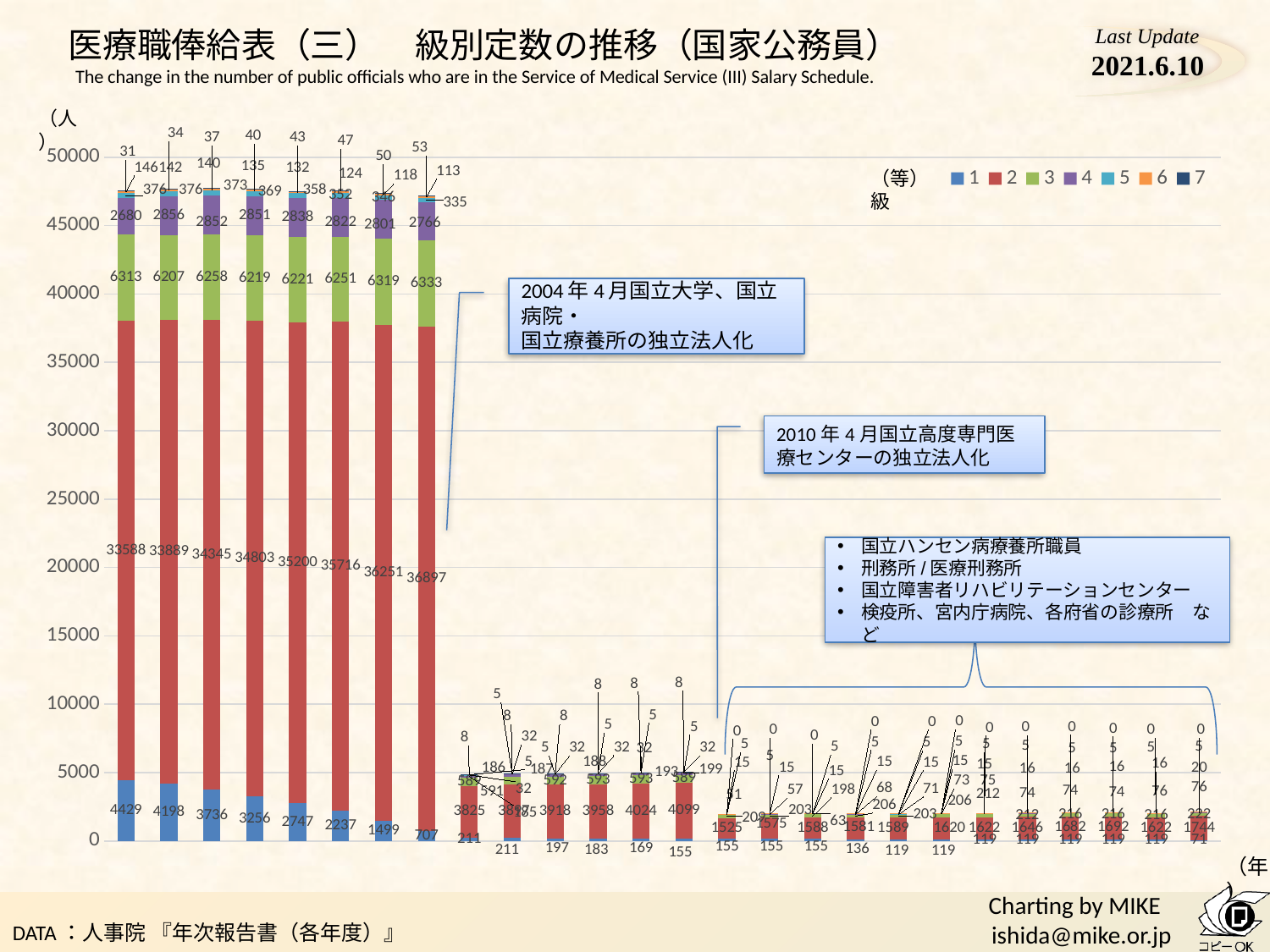
Across the first eight tall bars, does the value for grade 2 rise or fall from left to right? Rise What is the value for grade 1 (級 1) in the leftmost bar? 4429 What is the value for grade 3 (級 3) in the eighth bar from the left (the last of the tall bars)? 6333 What is the total of the leftmost stacked bar? 47563 How many series (grades) does the legend list? 7 What is the difference between the grade 1 value in the leftmost bar (4429) and the grade 1 value in the eighth bar (707)? 3722 In the leftmost bar, which grade has the largest value? Grade 2 Across the first eight tall bars, does the value for grade 1 rise or fall from left to right? Fall What is the value for grade 7 (級 7) in the leftmost bar? 31 What is the value for grade 2 (級 2) in the leftmost bar? 33588 What kind of chart is shown on the slide? Stacked bar chart In the leftmost bar, which is larger: the value for grade 3 or the value for grade 4? Grade 3